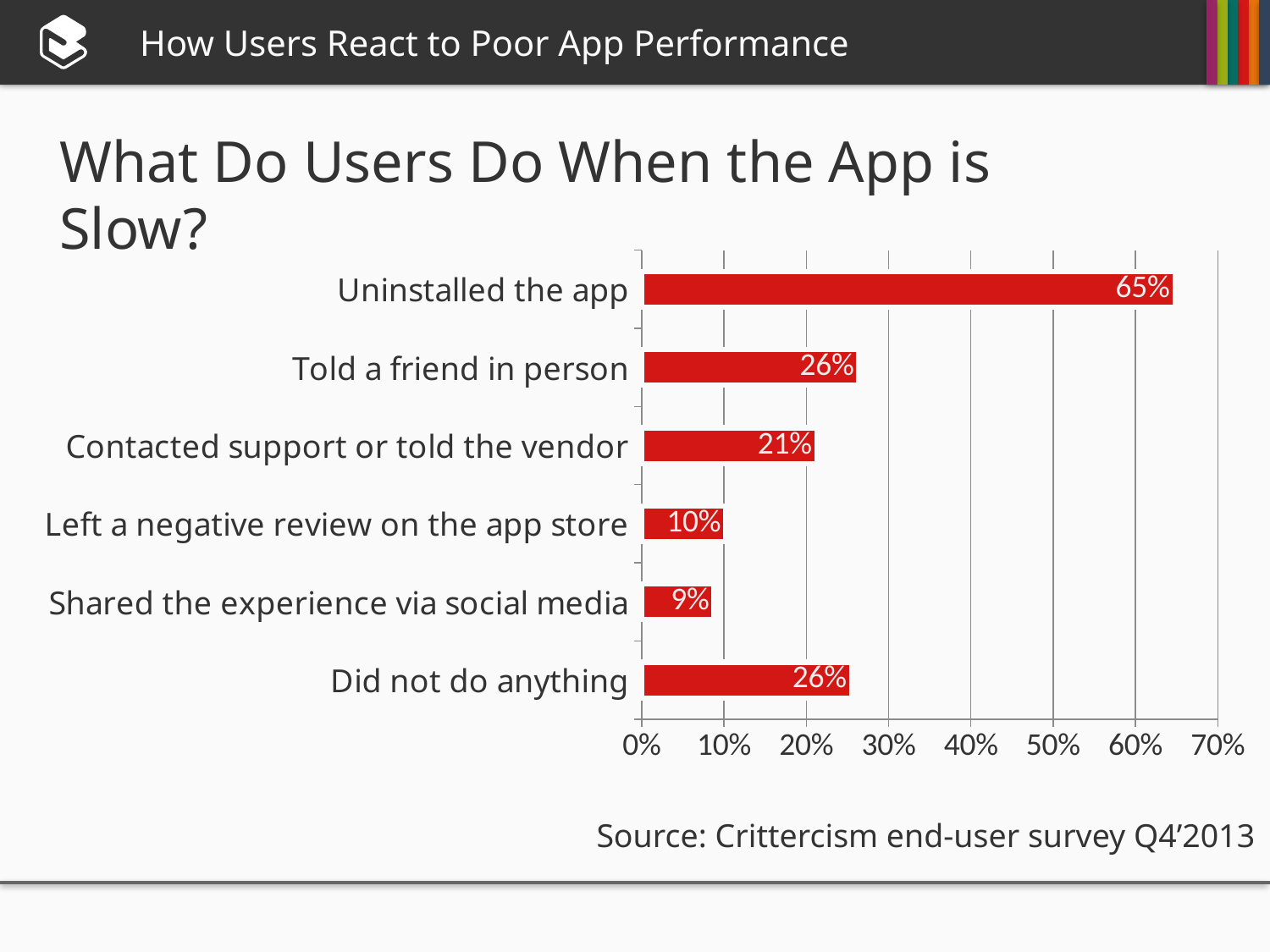
What percentage of users contacted support or told the vendor? 21% What percentage of users shared the experience via social media? 9% Which response has the highest percentage? Uninstalled the app Is the value for 'Uninstalled the app' greater or less than 60%? greater What is the source cited for the chart data? Crittercism end-user survey Q4'2013 What type of chart is shown on the slide? Bar chart What is the difference between the percentage who uninstalled the app and the percentage who told a friend in person? 39% Which is larger: the percentage who contacted support or told the vendor, or the percentage who left a negative review on the app store? Contacted support or told the vendor What percentage of users left a negative review on the app store? 10% How many response categories are shown in the chart? 6 What percentage of users uninstalled the app? 65% Which response has the lowest percentage? Shared the experience via social media